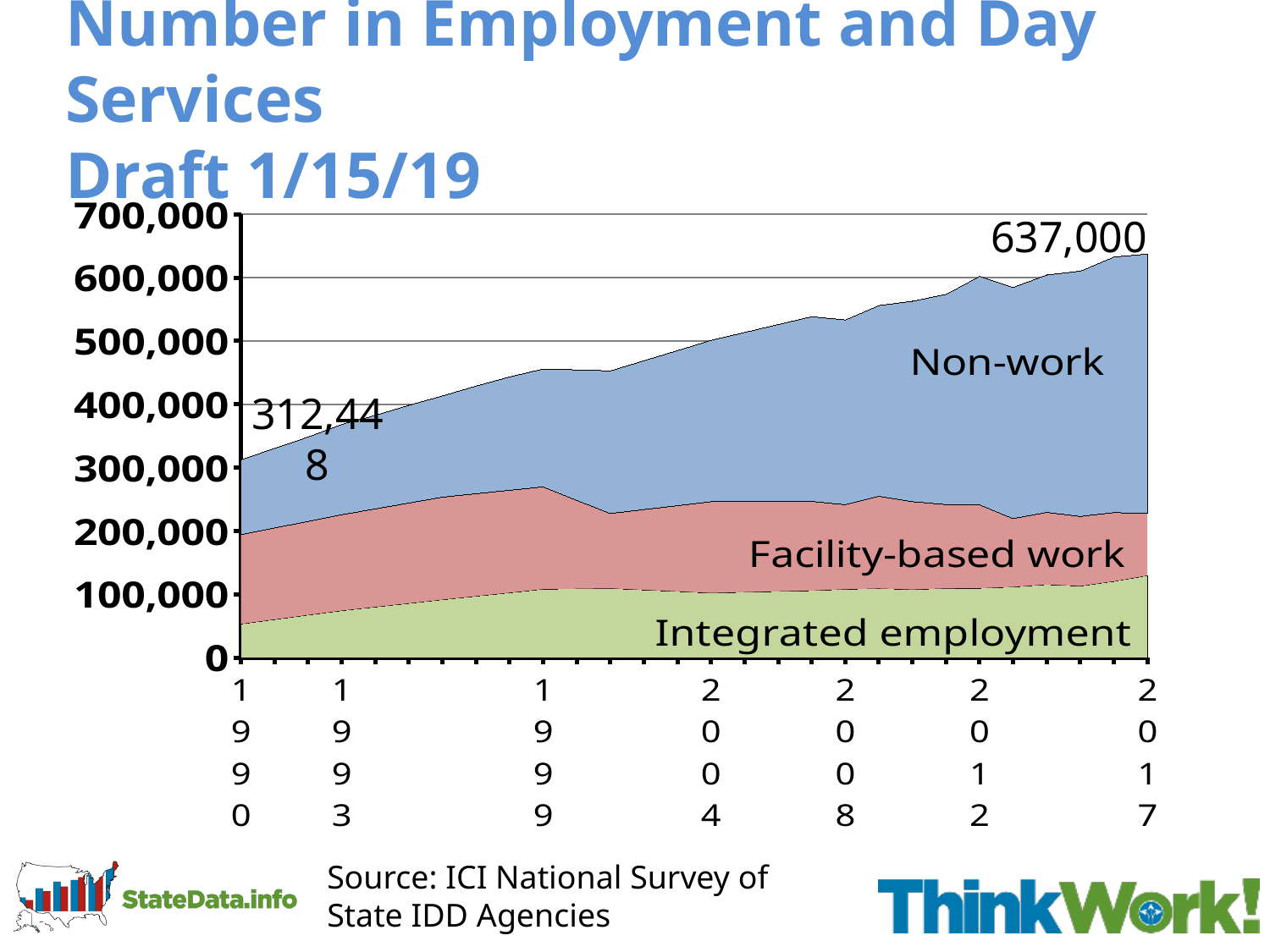
What is the total number in employment and day services shown for 1990? 312,448 By how much did the total increase from 1990 (312,448) to 2017 (637,000)? 324,552 What kind of chart is shown on the slide? area chart Which year has the larger total, 1990 or 2017? 2017 What is the source cited for the chart data? ICI National Survey of State IDD Agencies Does the total number in employment and day services rise or fall from 1990 to 2017? rise How many series (stacked areas) are shown in the chart? 3 Is the total for 1990 greater or less than 400,000? less What is the total number in employment and day services shown for 2017? 637,000 How many years are labeled on the x axis? 7 Which series is shown at the top of the stacked areas? Non-work Is the total for 2017 greater or less than 600,000? greater